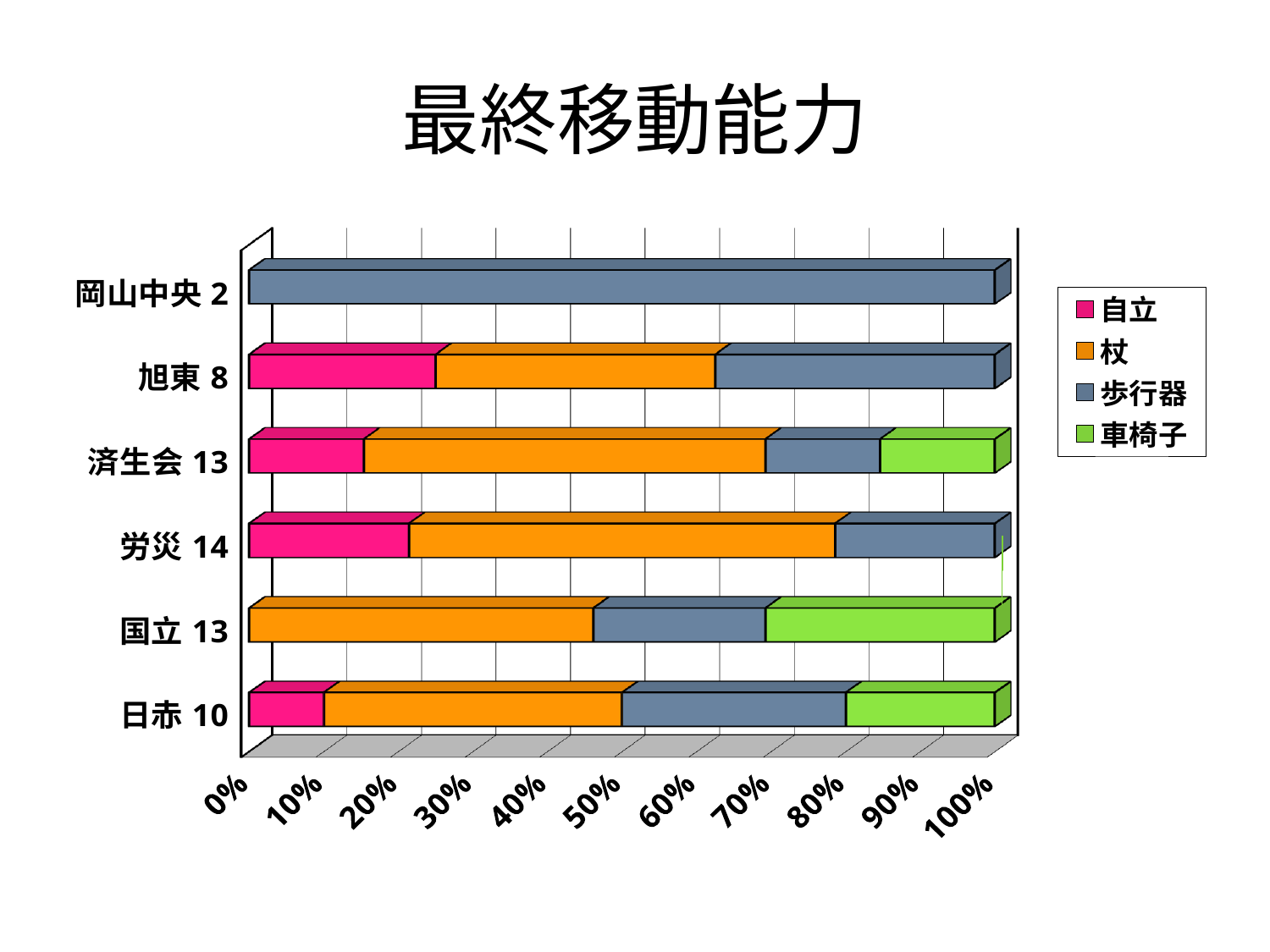
Is the 歩行器 share for 岡山中央 2 greater or less than 90%? greater Which category's bar consists entirely of the 歩行器 segment? 岡山中央 2 Is the 自立 share for 済生会 13 greater or less than 20%? less Which legend entry is shown in green? 車椅子 Which has the larger 自立 share, 旭東 8 or 済生会 13? 旭東 8 How many hospital categories are plotted on the chart? 6 What is the title of the chart? 最終移動能力 How many series does the legend list? 4 Is the 杖 share for 国立 13 greater or less than 40%? greater What kind of chart is shown on the slide? Stacked bar chart Which has the larger 車椅子 share, 国立 13 or 日赤 10? 国立 13